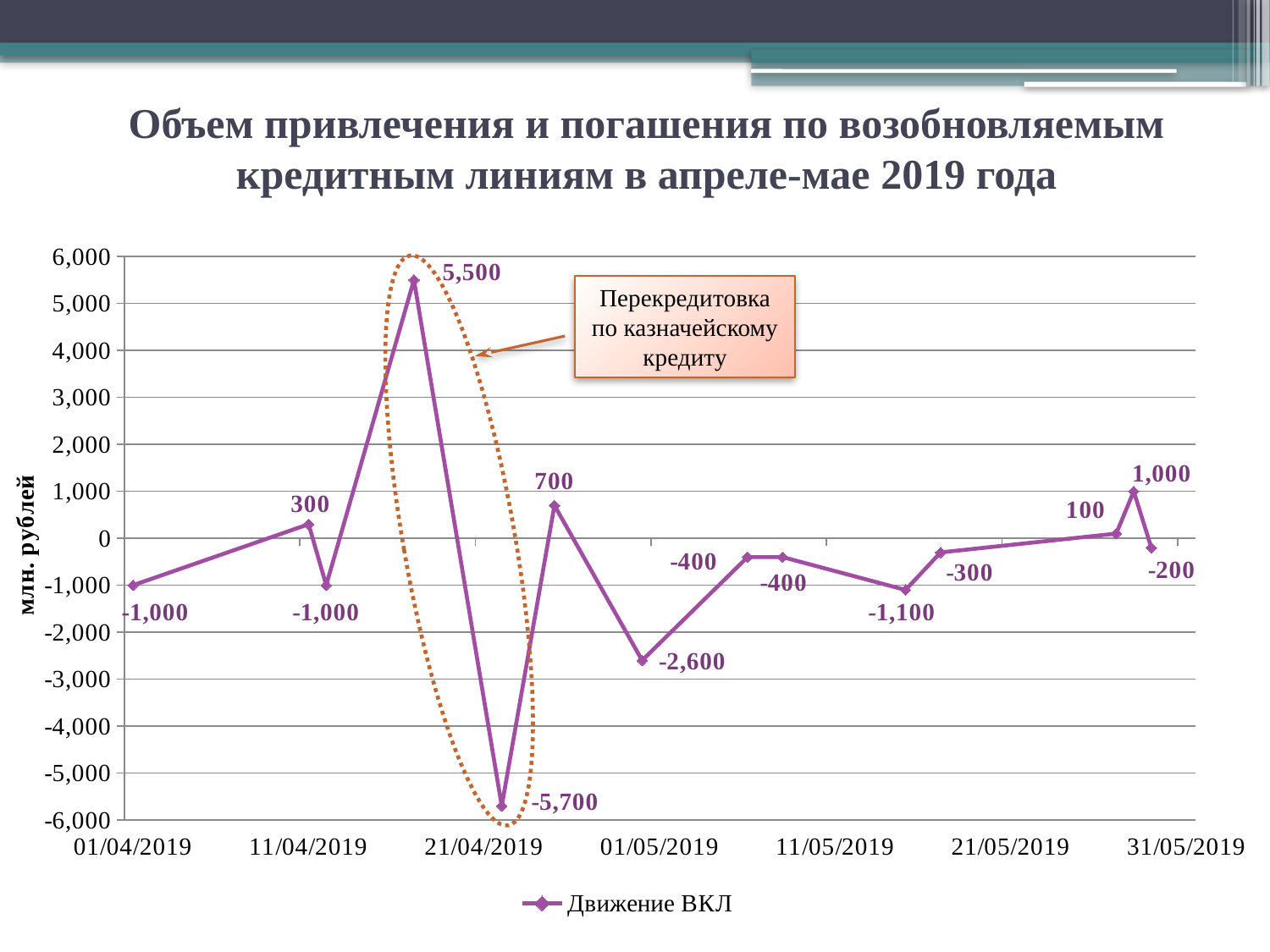
What is the name of the series shown in the legend? Движение ВКЛ What is the lowest value plotted on the chart? -5,700 Is the value of the data point labelled -2,600 greater or less than -2,000? less Which is larger: the data point labelled 700 or the data point labelled 1,000? 1,000 What is the value of the first data point, at 01/04/2019? -1,000 How many series does the legend list? 1 What text is written in the callout box pointing to the circled spike? Перекредитовка по казначейскому кредиту What is the value of the last data point on the chart? -200 What is the difference between the highest value (5,500) and the lowest value (-5,700) on the chart? 11,200 What kind of chart is shown on the slide? line chart What is the highest value plotted on the chart? 5,500 How many data points are plotted on the line? 14